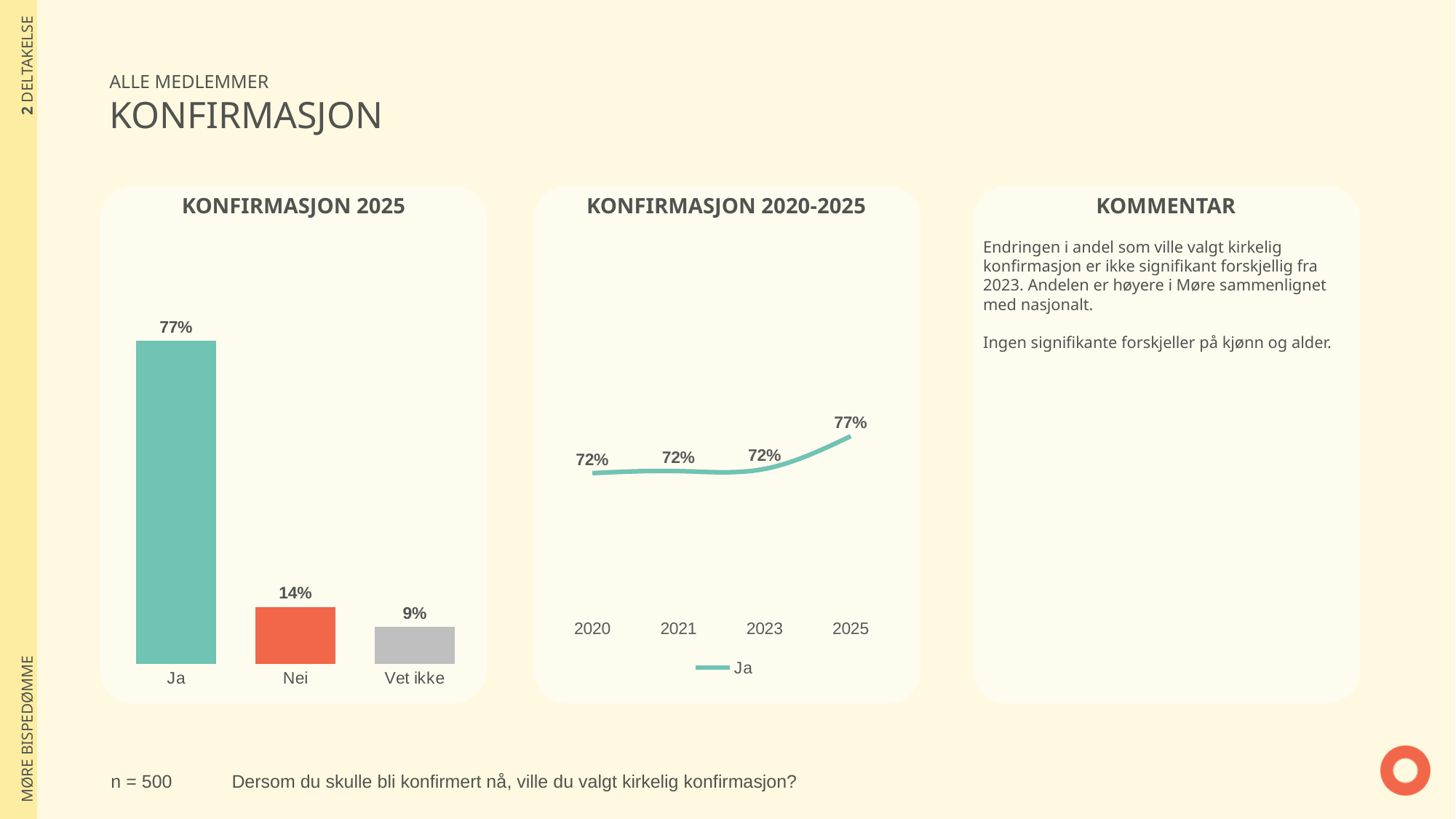
In the KONFIRMASJON 2020-2025 chart, what is the value for 2021? 72% In the KONFIRMASJON 2025 chart, what is the value for Nei? 14% In the KONFIRMASJON 2020-2025 chart, how many series does the legend list? 1 What kind of chart is the KONFIRMASJON 2025 chart? Bar chart In the KONFIRMASJON 2025 chart, what is the value for Ja? 77% In the KONFIRMASJON 2025 chart, which category has the lowest value? Vet ikke In the KONFIRMASJON 2025 chart, which category has the highest value? Ja In the KONFIRMASJON 2020-2025 chart, what is the difference between 2025 and 2023? 5 percentage points In the KONFIRMASJON 2025 chart, what is the difference between Ja and Nei? 63 percentage points In the KONFIRMASJON 2025 chart, what is the value for Vet ikke? 9% What kind of chart is the KONFIRMASJON 2020-2025 chart? Line chart In the KONFIRMASJON 2025 chart, how many categories are shown? 3